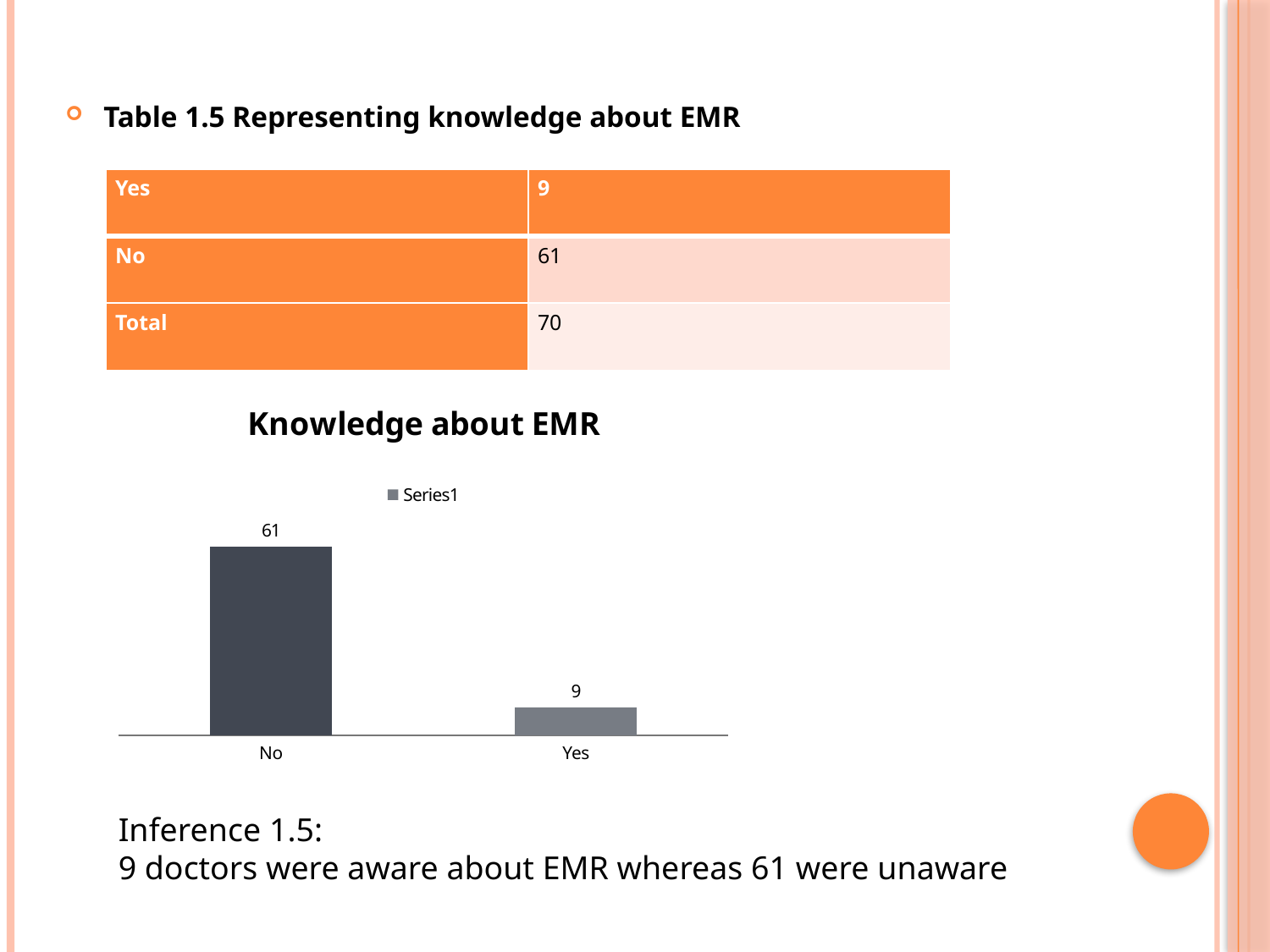
Which category has the highest value in the Knowledge about EMR chart? No Which category has the lowest value in the Knowledge about EMR chart? Yes How many series does the legend of the Knowledge about EMR chart list? 1 What is the total of the values for No and Yes in the Knowledge about EMR chart? 70 What is the value for Yes in the Knowledge about EMR chart? 9 What is the title of the chart on the slide? Knowledge about EMR What is the difference between the values for No and Yes in the Knowledge about EMR chart? 52 What is the value for No in the Knowledge about EMR chart? 61 What kind of chart is the Knowledge about EMR chart? Bar chart How many categories are shown in the Knowledge about EMR chart? 2 Which is larger in the Knowledge about EMR chart, the value for No or the value for Yes? No What is the name of the series listed in the legend of the Knowledge about EMR chart? Series1